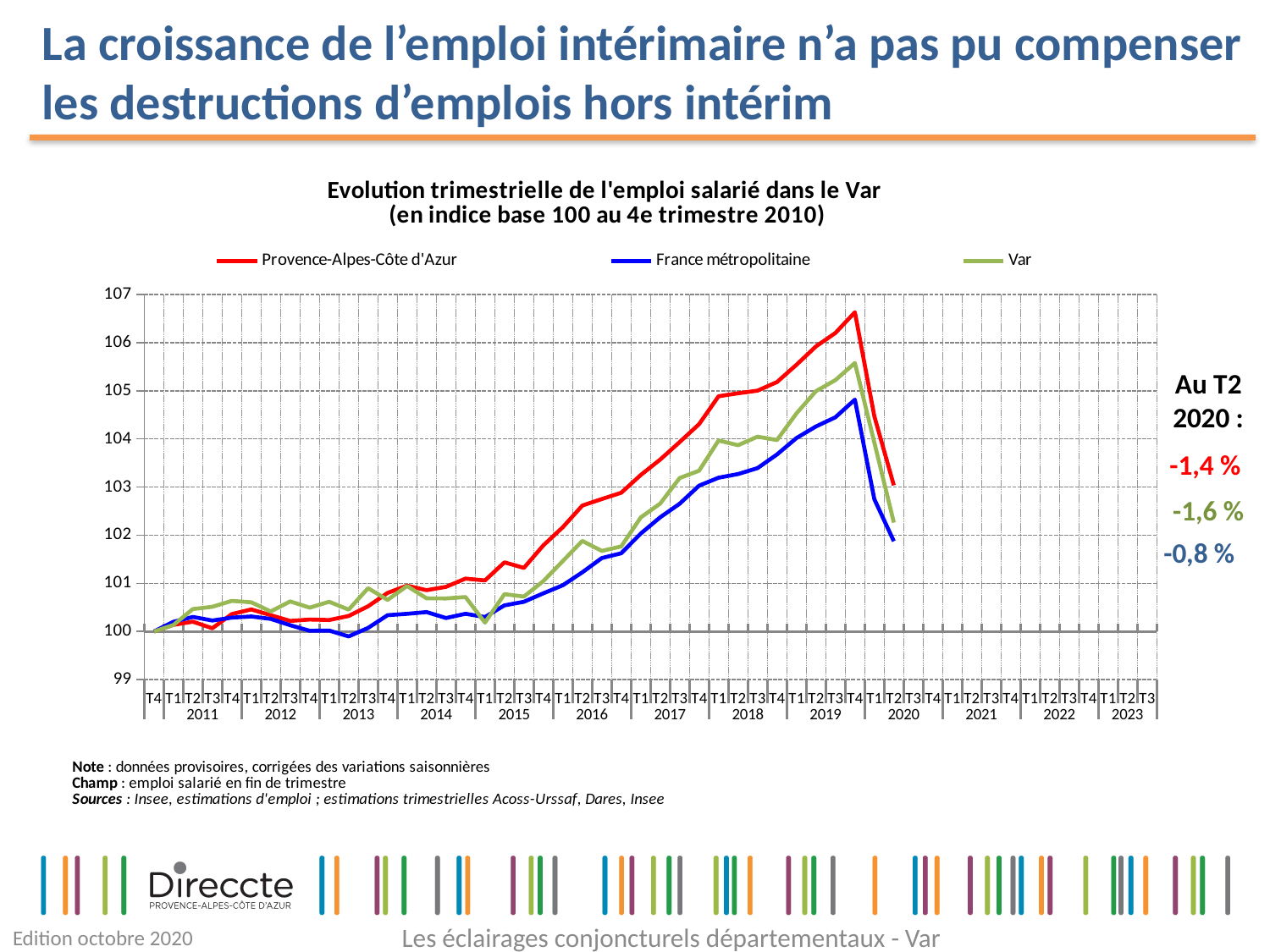
What is the index value of all three series at T4 2010? 100 Which three series are listed in the chart legend? Provence-Alpes-Côte d'Azur, France métropolitaine, Var What change is shown for Var at T2 2020 in the annotation on the right? -1,6 % Which series has the highest index value at T4 2019? Provence-Alpes-Côte d'Azur Do the three series rise or fall between T4 2019 and T2 2020? fall What change is shown for France métropolitaine at T2 2020 in the annotation on the right? -0,8 % What change is shown for Provence-Alpes-Côte d'Azur at T2 2020 in the annotation on the right? -1,4 % How many series does the chart legend list? 3 What is the title of the chart? Evolution trimestrielle de l'emploi salarié dans le Var (en indice base 100 au 4e trimestre 2010) Is the value for Provence-Alpes-Côte d'Azur at T4 2019 greater or less than 106? greater What kind of chart is shown on the slide? line chart Which series has the lowest index value at T4 2019? France métropolitaine